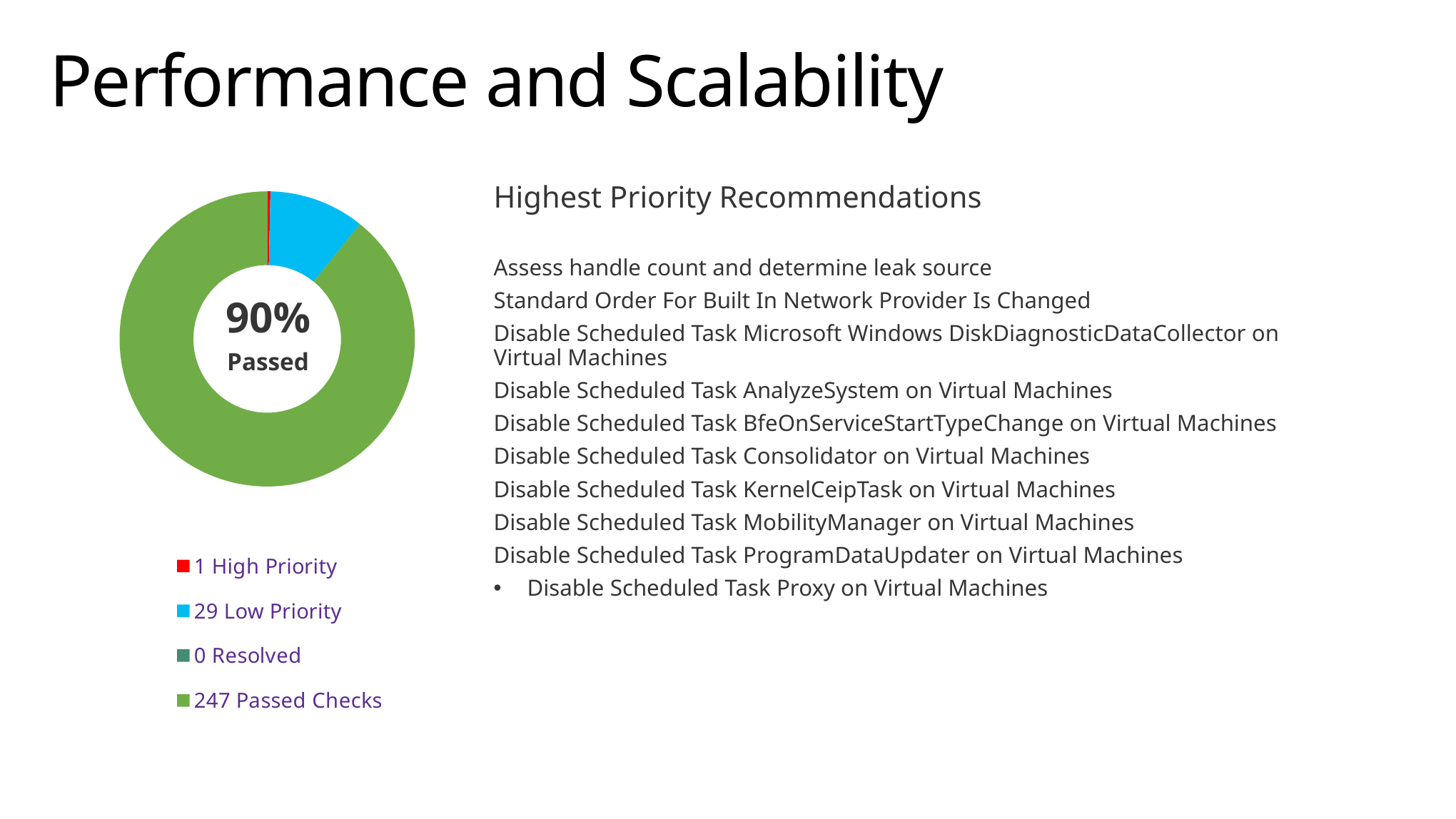
How many categories does the chart's legend list? 4 How many Low Priority items does the legend show? 29 What percentage is shown in the centre of the doughnut chart? 90% How many Passed Checks does the legend show? 247 What colour represents Passed Checks in the chart? Green Which is larger, the number of Low Priority items or the number of High Priority items? Low Priority What is the difference between the number of Low Priority items and High Priority items? 28 What kind of chart is shown on the slide? Doughnut chart How many Resolved items does the legend show? 0 Which category has the smallest value in the chart? Resolved Which category has the largest value in the chart? Passed Checks How many High Priority items does the legend show? 1